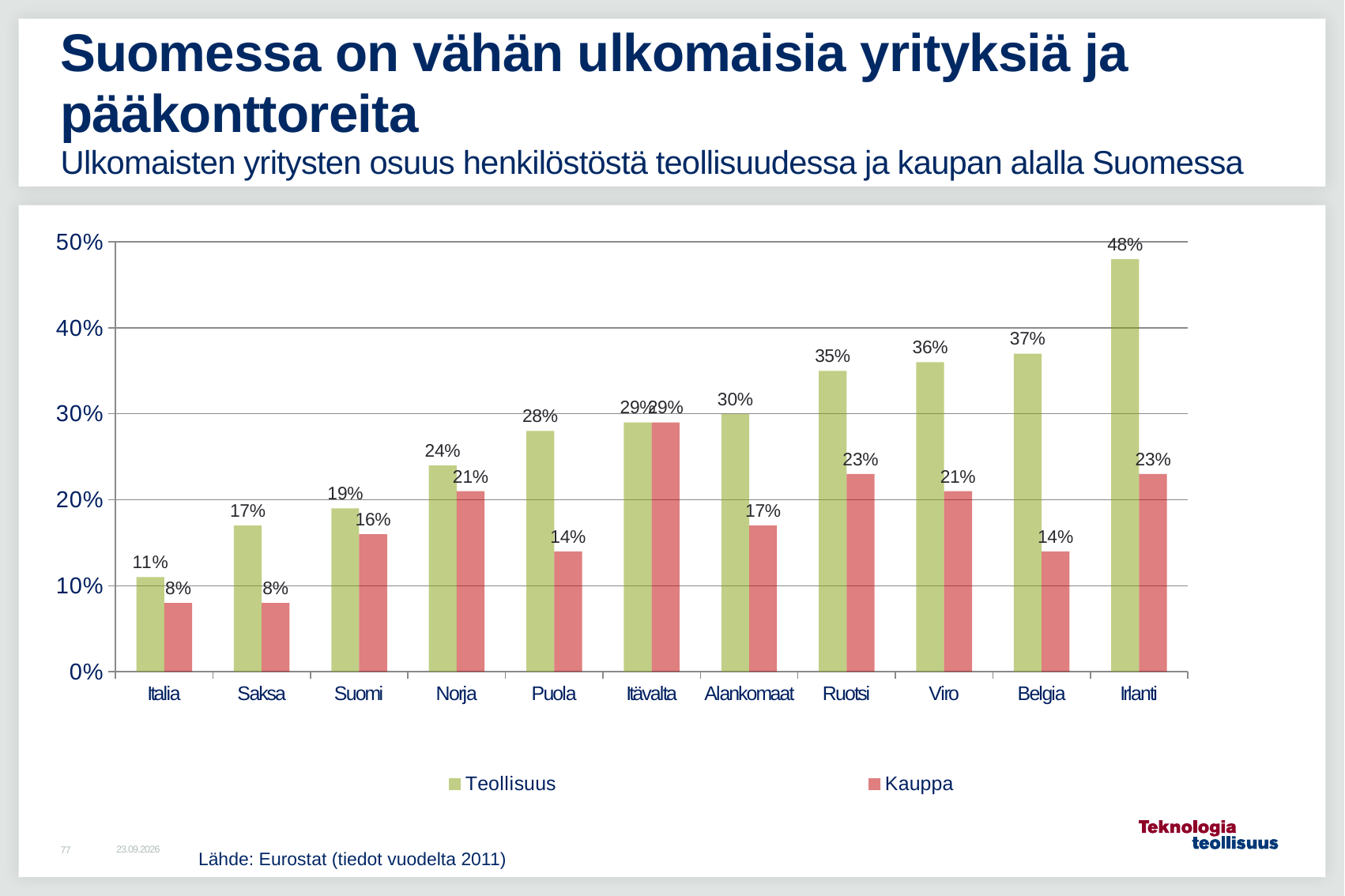
What is the Teollisuus value for Suomi? 19% Is the Teollisuus value for Belgia greater or less than 30%? greater What is the Kauppa value for Ruotsi? 23% What is the difference between the Teollisuus and Kauppa values for Irlanti? 25% What colour are the Kauppa bars? red Do the Teollisuus values generally rise or fall from Italia to Irlanti? rise Which country has the highest Teollisuus value? Irlanti Which country has the lowest Teollisuus value? Italia What kind of chart is shown on the slide? bar chart How many series does the legend list? 2 Which is larger for Puola, the Teollisuus value or the Kauppa value? Teollisuus How many countries are shown on the x axis? 11